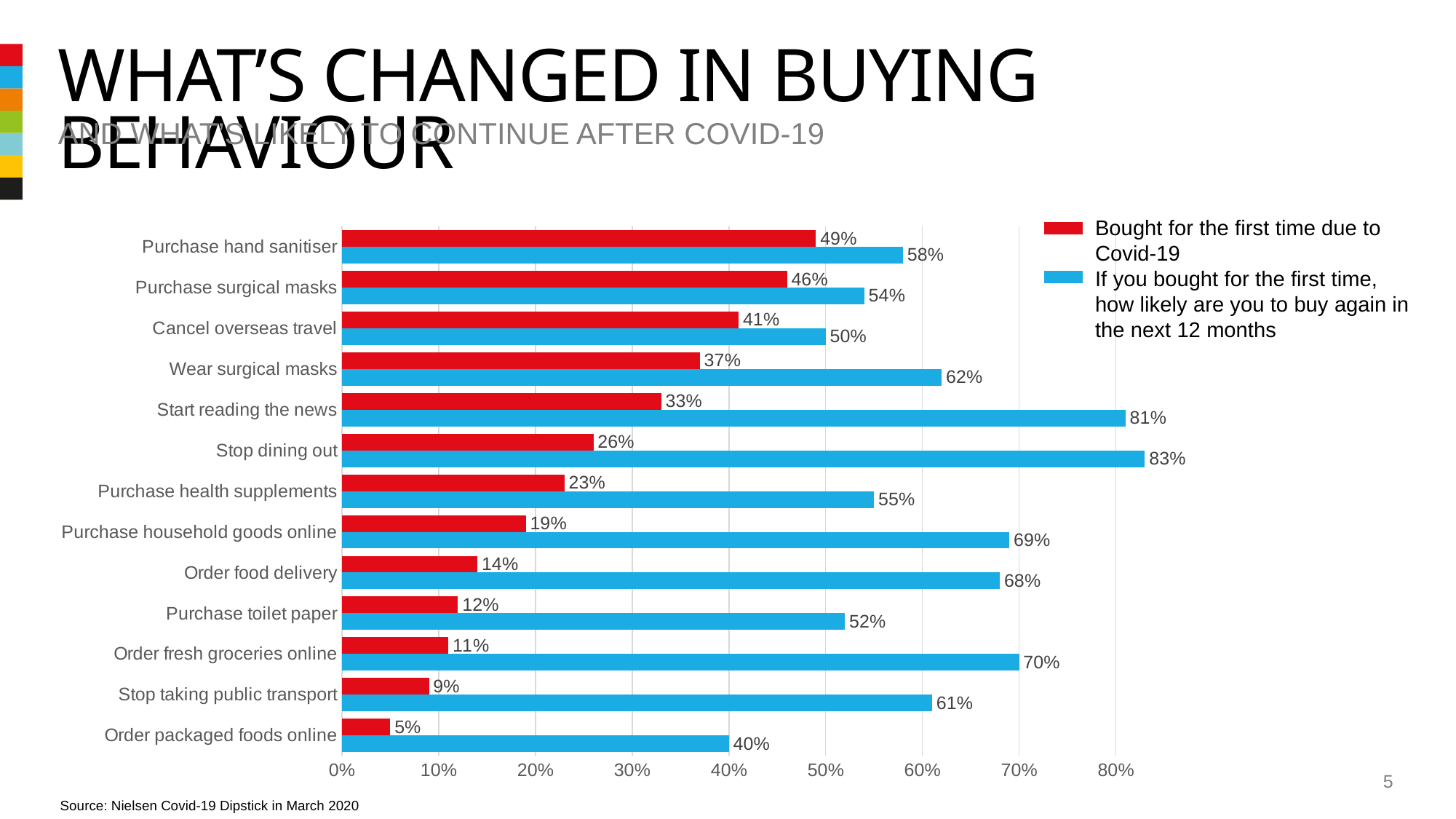
Which is larger for 'Purchase toilet paper': the 'Bought for the first time due to Covid-19' value or the likelihood to buy again value? Likelihood to buy again (52%) For 'Stop dining out', what is the value for 'If you bought for the first time, how likely are you to buy again in the next 12 months'? 83% How many series does the legend list? 2 What kind of chart is shown on the slide? Bar chart Which category has the highest value for 'Bought for the first time due to Covid-19'? Purchase hand sanitiser What is the 'Bought for the first time due to Covid-19' value for 'Order fresh groceries online'? 11% Which category has the lowest value for 'If you bought for the first time, how likely are you to buy again in the next 12 months'? Order packaged foods online What is the difference between the two values shown for 'Start reading the news'? 48% What is the source cited for the chart data? Nielsen Covid-19 Dipstick in March 2020 Which colour represents 'Bought for the first time due to Covid-19' in the legend? Red How many categories are shown on the chart? 13 What percentage of respondents bought hand sanitiser for the first time due to Covid-19? 49%